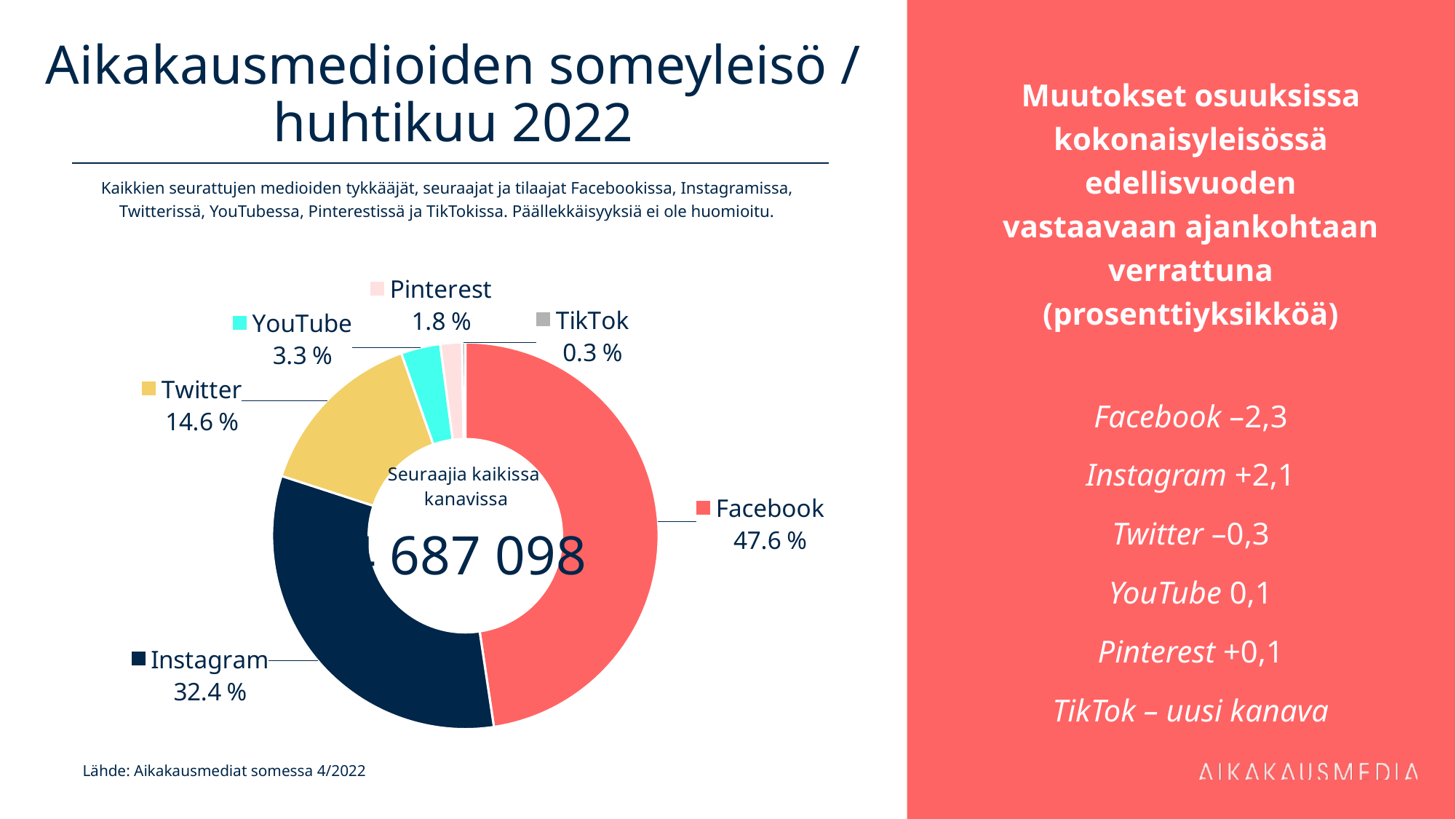
Which has a larger share, Twitter or YouTube? Twitter What type of chart is shown on the slide? Donut (pie) chart Which channel has the largest share of the audience? Facebook What share of the social media audience does Instagram have? 32.4 % How many percentage points larger is Facebook's share than Instagram's? 15.2 What share of the social media audience does Facebook have? 47.6 % Which channel has the smallest share of the audience? TikTok What share does Twitter have in the chart? 14.6 % What share does YouTube have in the chart? 3.3 % What is the difference in percentage points between Pinterest's and TikTok's shares? 1.5 How many channels are shown in the chart? 6 What share does TikTok have in the chart? 0.3 %